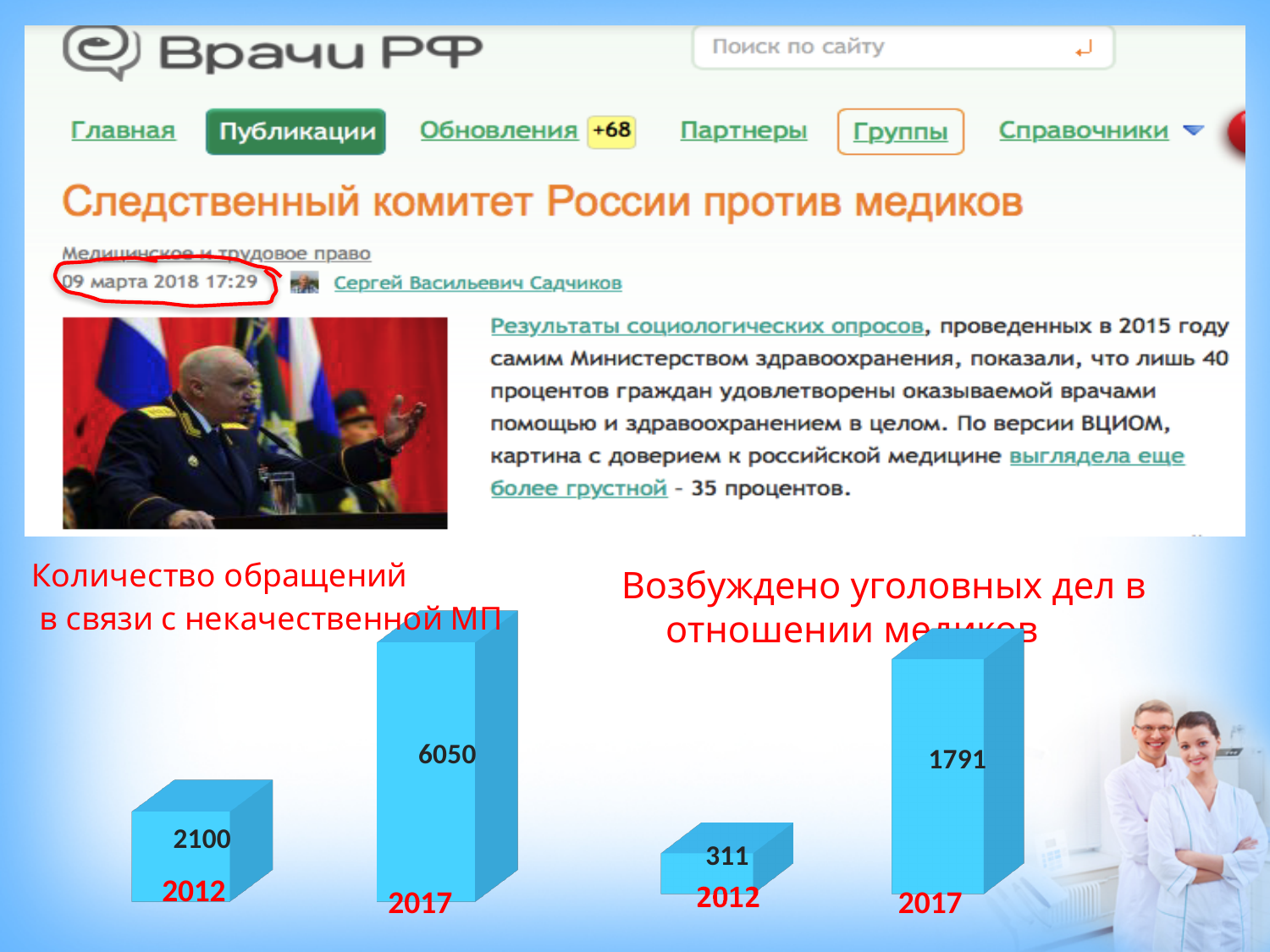
How many bars does the left chart have? 2 In the left chart, which year has the higher value? 2017 In the left chart (Количество обращений в связи с некачественной МП), what is the value for 2017? 6050 In the right chart, which year has the lower value? 2012 In the right chart (Возбуждено уголовных дел в отношении медиков), what is the value for 2012? 311 In the left chart, do the values rise or fall from 2012 to 2017? rise What type of chart is the right chart (Возбуждено уголовных дел в отношении медиков)? bar chart In the left chart, what is the difference between the 2017 and 2012 values? 3950 In the right chart, what is the difference between the 2017 and 2012 values? 1480 In the left chart (Количество обращений в связи с некачественной МП), what is the value for 2012? 2100 In the right chart (Возбуждено уголовных дел в отношении медиков), what is the value for 2017? 1791 In the right chart, is the value for 2012 larger or smaller than the value for 2017? smaller